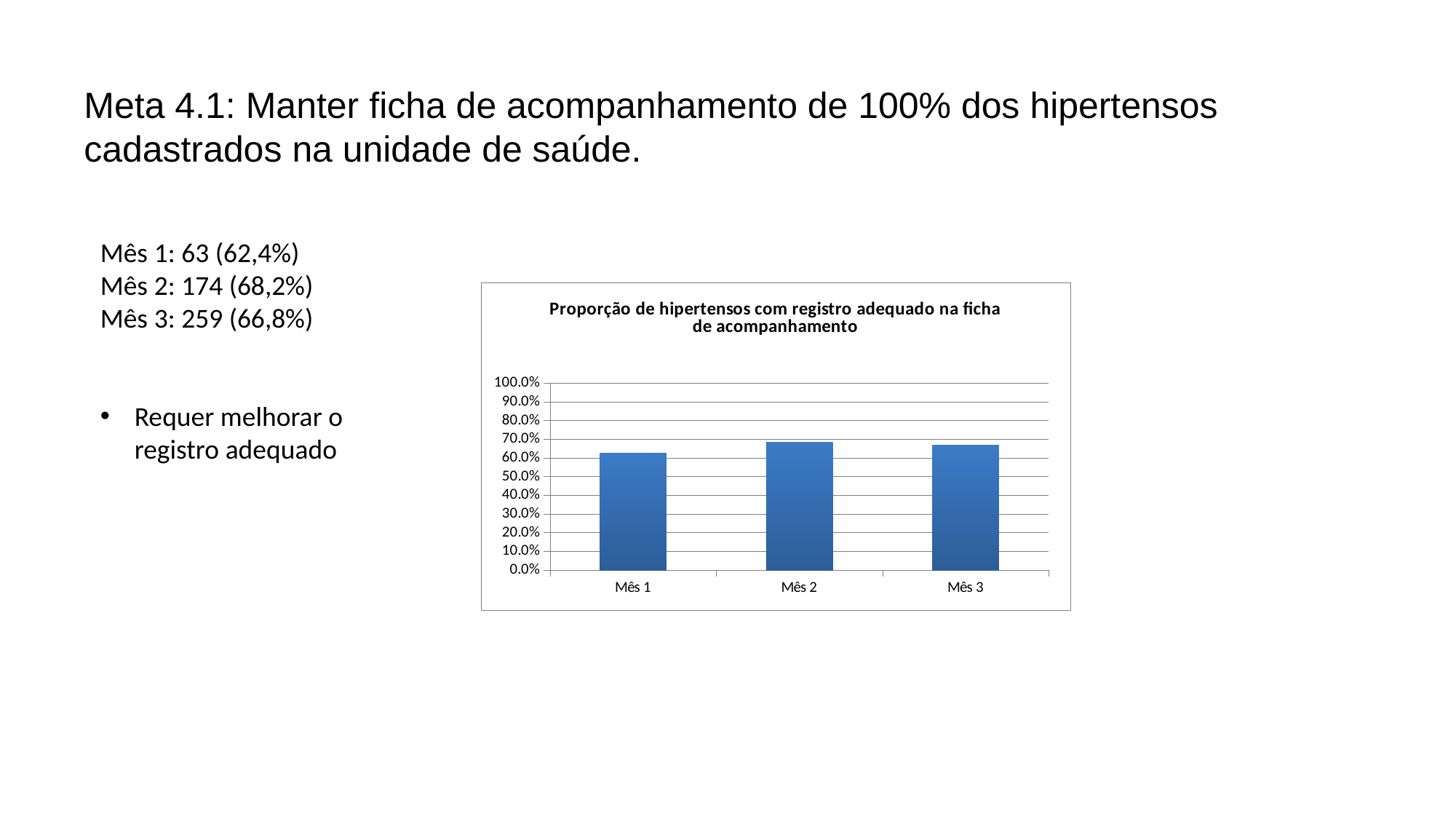
Is the bar for Mês 2 taller or shorter than the bar for Mês 1? taller Is the value for Mês 1 greater or less than 60.0%? greater Which month has the lowest bar in the chart? Mês 1 What kind of chart is shown on the slide? bar chart Do the bars rise steadily from Mês 1 to Mês 3, or do they rise and then fall? rise and then fall Is the value for Mês 3 greater or less than 60.0%? greater How many categories (months) are plotted on the x axis of the chart? 3 Is the value for Mês 1 greater or less than 70.0%? less According to the text on the slide, what proportion is reported for Mês 1? 62,4% What is the title of the chart? Proporção de hipertensos com registro adequado na ficha de acompanhamento Which month has the highest bar in the chart? Mês 2